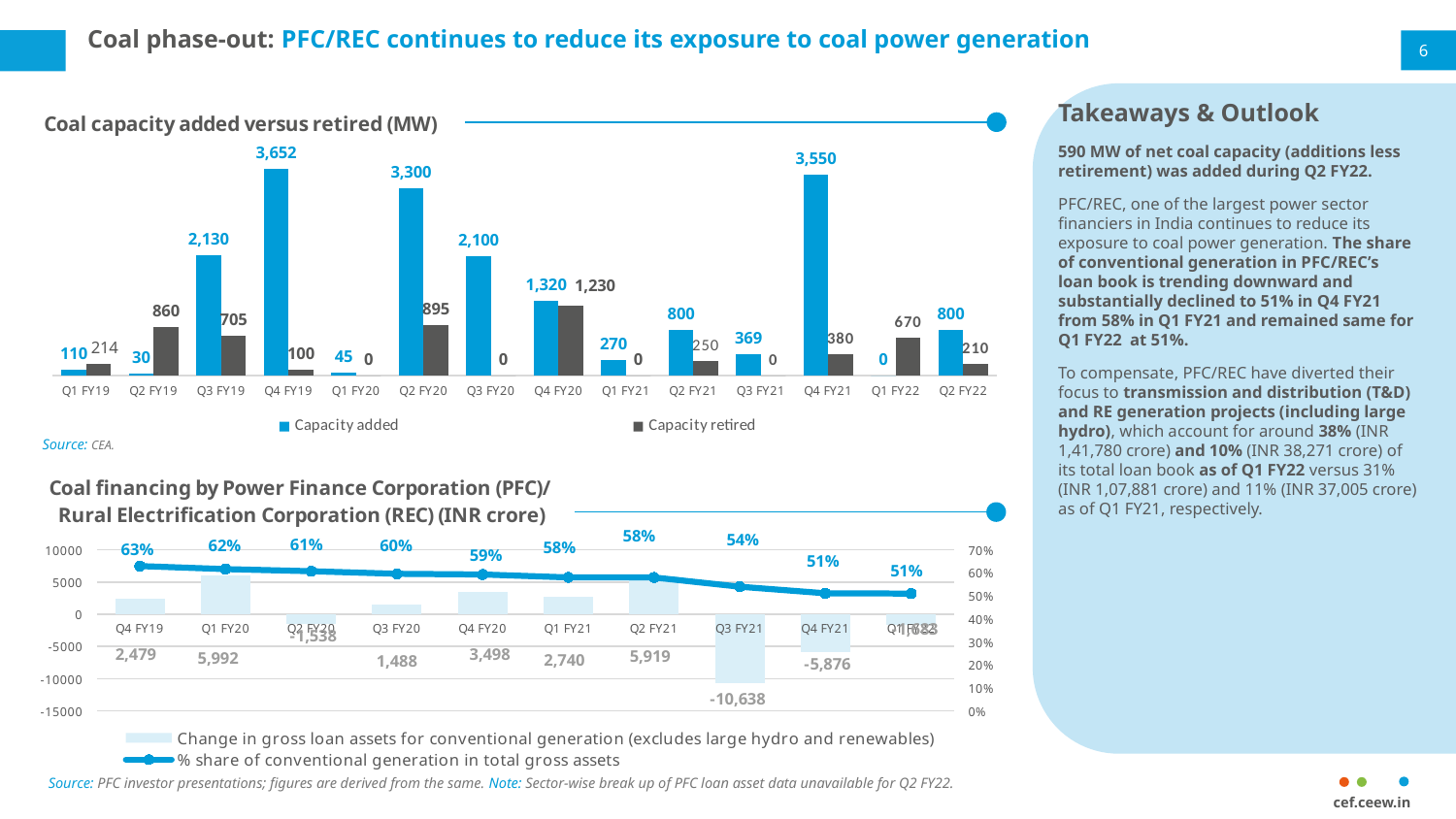
In the 'Coal capacity added versus retired (MW)' chart, which is larger in Q2 FY19: capacity added or capacity retired? Capacity retired In the 'Coal capacity added versus retired (MW)' chart, what is the difference between capacity added and capacity retired in Q2 FY22? 590 In the 'Coal capacity added versus retired (MW)' chart, what was the capacity added in Q4 FY19? 3,652 In the 'Coal capacity added versus retired (MW)' chart, which quarter had the highest capacity added? Q4 FY19 What type of chart is the 'Coal capacity added versus retired (MW)' chart? Bar chart In the 'Coal financing by PFC/REC (INR crore)' chart, what was the % share of conventional generation in total gross assets in Q4 FY19? 63% In the 'Coal financing by PFC/REC (INR crore)' chart, what was the change in gross loan assets for conventional generation in Q3 FY21? -10,638 In the 'Coal financing by PFC/REC (INR crore)' chart, which quarter had the lowest change in gross loan assets for conventional generation? Q3 FY21 In the 'Coal financing by PFC/REC (INR crore)' chart, does the % share of conventional generation rise or fall from Q4 FY19 to Q1 FY22? Fall In the 'Coal capacity added versus retired (MW)' chart, what was the capacity retired in Q4 FY20? 1,230 How many quarters are shown on the x axis of the 'Coal capacity added versus retired (MW)' chart? 14 How many series does the legend of the 'Coal capacity added versus retired (MW)' chart list? 2